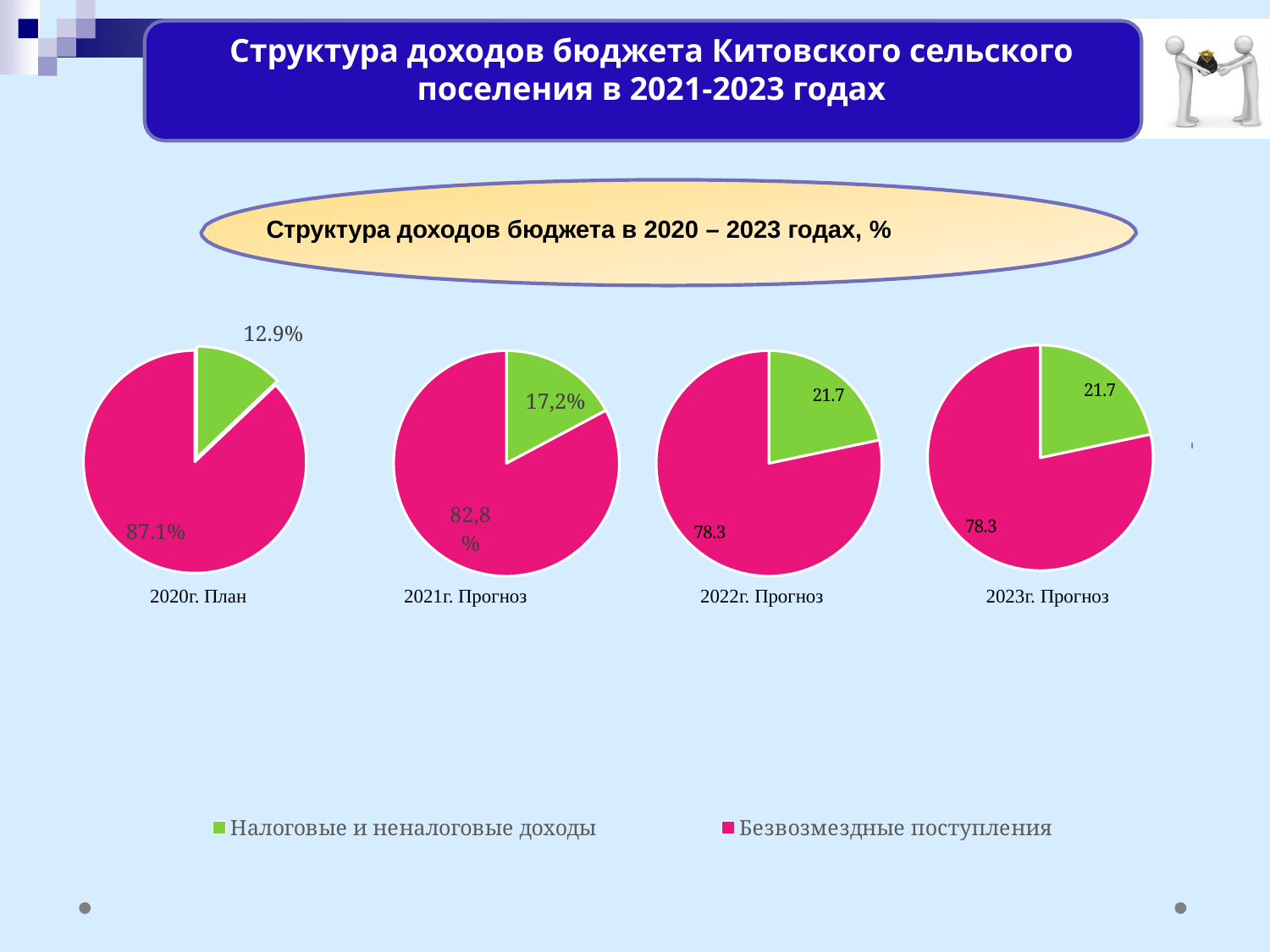
In the pie chart labelled 2022г. Прогноз, what value is shown for Налоговые и неналоговые доходы? 21.7 How many series does the legend list? 2 In the pie chart labelled 2022г. Прогноз, which slice is the smallest? Налоговые и неналоговые доходы How many pie charts are shown on the slide? 4 What type of chart is used to show the budget revenue structure on this slide? Pie chart In the pie chart labelled 2020г. План, what is the difference between the Безвозмездные поступления share and the Налоговые и неналоговые доходы share? 74.2% In the pie chart labelled 2021г. Прогноз, what value is shown for Безвозмездные поступления? 82,8 % In the pie chart labelled 2020г. План, which slice is larger: Налоговые и неналоговые доходы or Безвозмездные поступления? Безвозмездные поступления In the pie chart labelled 2020г. План, what share is shown for Налоговые и неналоговые доходы? 12.9% In the pie chart labelled 2021г. Прогноз, what value is shown for Налоговые и неналоговые доходы? 17,2% In the pie chart labelled 2023г. Прогноз, what value is shown for Безвозмездные поступления? 78.3 In the pie chart labelled 2020г. План, what share is shown for Безвозмездные поступления? 87.1%